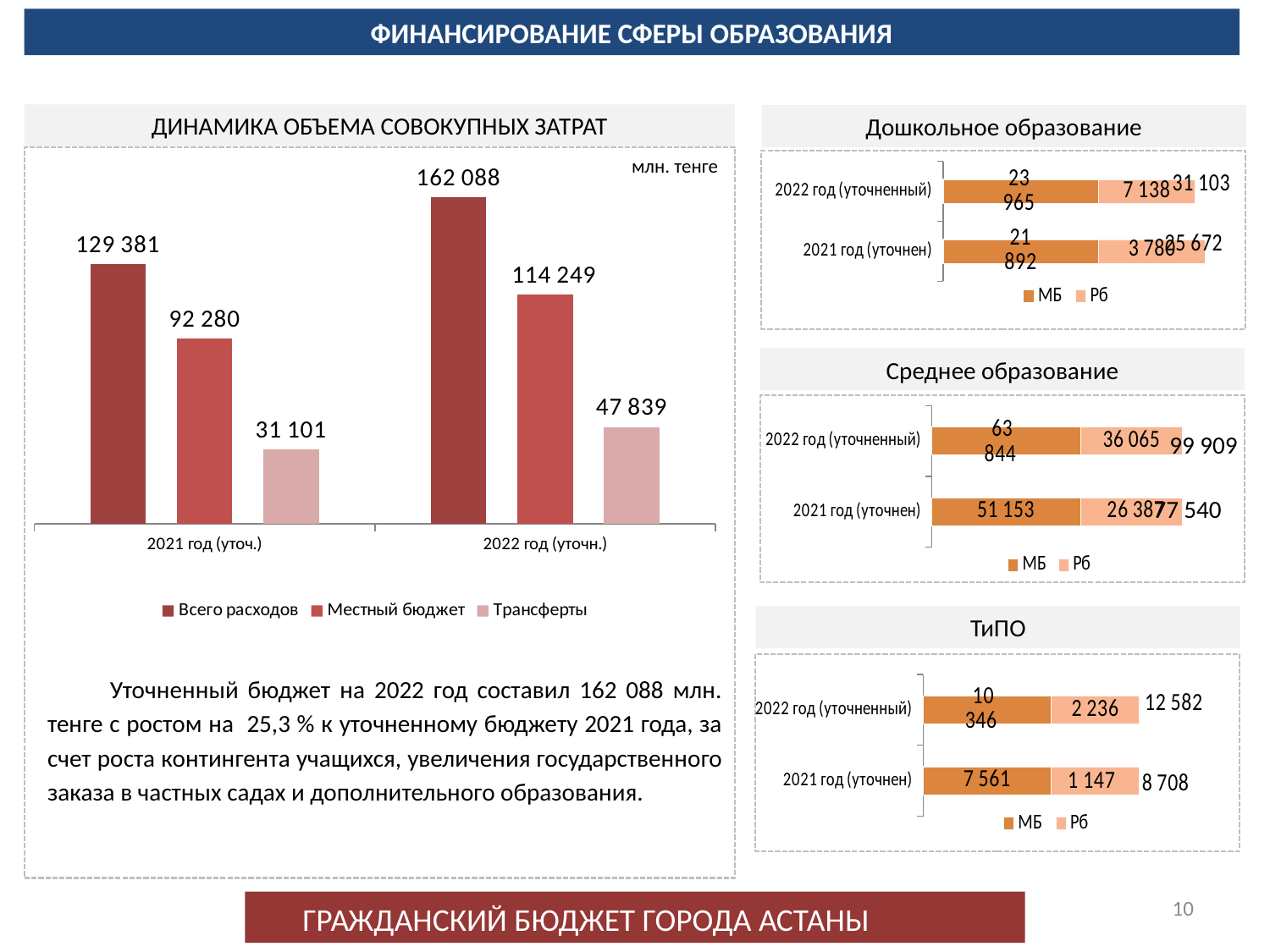
In the chart 'ДИНАМИКА ОБЪЕМА СОВОКУПНЫХ ЗАТРАТ', what is the value of 'Всего расходов' for 2022 год (уточн.)? 162 088 What kind of chart is 'ДИНАМИКА ОБЪЕМА СОВОКУПНЫХ ЗАТРАТ'? bar chart In the chart 'Дошкольное образование', what is the МБ value for 2022 год (уточненный)? 23 965 In the chart 'Среднее образование', what is the РБ value for 2022 год (уточненный)? 36 065 In the chart 'ДИНАМИКА ОБЪЕМА СОВОКУПНЫХ ЗАТРАТ', what is the difference between 'Местный бюджет' in 2022 and in 2021? 21 969 In the chart 'ТиПО', what is the total of the stacked bar for 2021 год (уточнен)? 8 708 In the chart 'ДИНАМИКА ОБЪЕМА СОВОКУПНЫХ ЗАТРАТ', how many series does the legend list? 3 In the chart 'ДИНАМИКА ОБЪЕМА СОВОКУПНЫХ ЗАТРАТ', what is the value of 'Трансферты' for 2021 год (уточ.)? 31 101 In the chart 'ТиПО', what is the difference between the РБ values for 2022 год (уточненный) and 2021 год (уточнен)? 1 089 In the chart 'Дошкольное образование', what is the total of the stacked bar for 2022 год (уточненный)? 31 103 In the chart 'ДИНАМИКА ОБЪЕМА СОВОКУПНЫХ ЗАТРАТ', does 'Всего расходов' rise or fall from 2021 to 2022? rise In the chart 'Среднее образование', which is larger: МБ for 2022 год (уточненный) or МБ for 2021 год (уточнен)? 2022 год (уточненный)